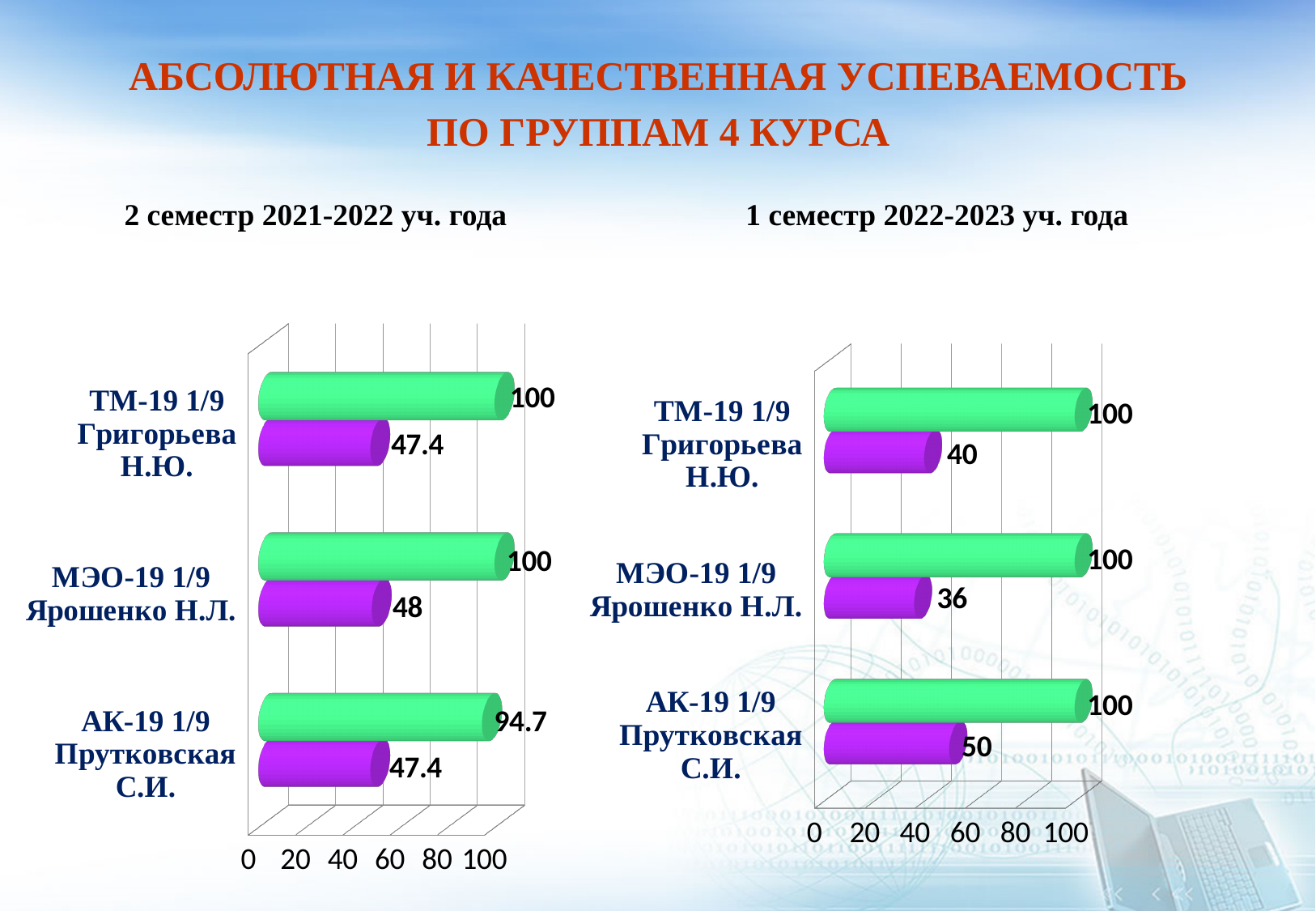
In the chart for 1 семестр 2022-2023 уч. года, which group has the highest purple bar value? АК-19 1/9 Прутковская С.И. In the chart for 1 семестр 2022-2023 уч. года, which group has the lowest purple bar value? МЭО-19 1/9 Ярошенко Н.Л. In the chart for 1 семестр 2022-2023 уч. года, what is the difference between the purple bar values for АК-19 1/9 Прутковская С.И. and МЭО-19 1/9 Ярошенко Н.Л.? 14 In the chart for 2 семестр 2021-2022 уч. года, what is the difference between the green and purple bar values for ТМ-19 1/9 Григорьева Н.Ю.? 52.6 In the chart for 1 семестр 2022-2023 уч. года, what is the value of the purple bar for ТМ-19 1/9 Григорьева Н.Ю.? 40 Which is larger: the purple bar for ТМ-19 1/9 Григорьева Н.Ю. in the 2 семестр 2021-2022 chart or in the 1 семестр 2022-2023 chart? 2 семестр 2021-2022 уч. года In the chart for 2 семестр 2021-2022 уч. года, what is the value of the purple bar for МЭО-19 1/9 Ярошенко Н.Л.? 48 In the chart for 2 семестр 2021-2022 уч. года, which group has the lowest green bar value? АК-19 1/9 Прутковская С.И. In the chart for 2 семестр 2021-2022 уч. года, what is the value of the green bar for АК-19 1/9 Прутковская С.И.? 94.7 What type of chart is used for 2 семестр 2021-2022 уч. года? Bar chart How many groups are shown in the chart for 1 семестр 2022-2023 уч. года? 3 In the chart for 1 семестр 2022-2023 уч. года, what is the value of the purple bar for МЭО-19 1/9 Ярошенко Н.Л.? 36